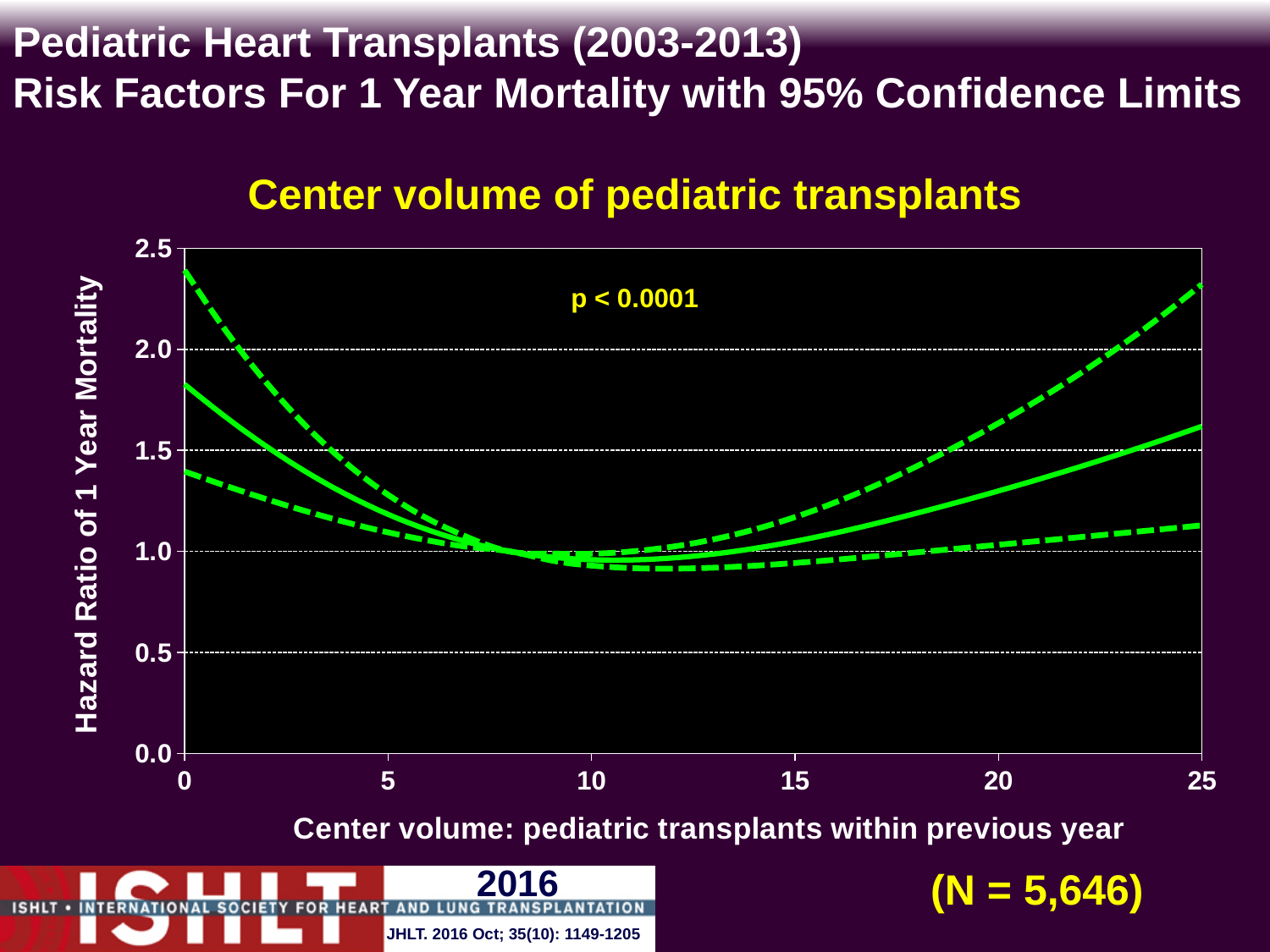
Is the upper dashed confidence limit at a center volume of 0 greater or less than 2.0? greater Does the solid hazard ratio line rise or fall as center volume increases from 10 to 25? rise What kind of chart is shown on the slide? line chart What is the title of the chart? Center volume of pediatric transplants Is the hazard ratio on the solid line at a center volume of 25 greater or less than 1.5? greater What p-value is printed on the chart? p < 0.0001 Is the upper dashed confidence limit at a center volume of 25 greater or less than 2.0? greater Does the solid hazard ratio line rise or fall as center volume increases from 0 to 10? fall How many lines are plotted on the chart? 3